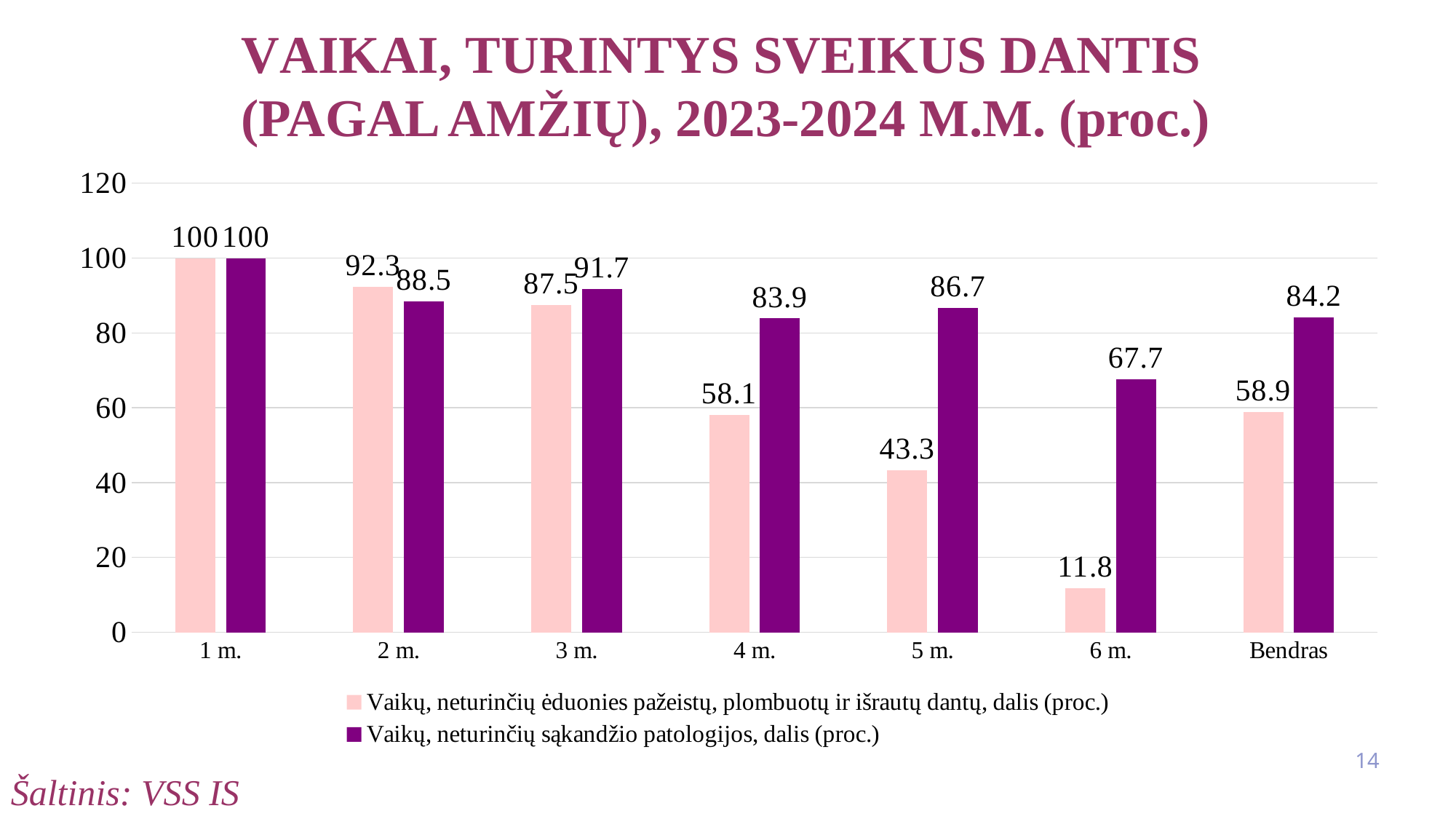
What is the value for Bendras in the series 'Vaikų, neturinčių ėduonies pažeistų, plombuotų ir išrautų dantų, dalis (proc.)'? 58.9 What is the value for 4 m. in the series 'Vaikų, neturinčių ėduonies pažeistų, plombuotų ir išrautų dantų, dalis (proc.)'? 58.1 What is the value for 5 m. in the series 'Vaikų, neturinčių sąkandžio patologijos, dalis (proc.)'? 86.7 Which category has the lowest value in the series 'Vaikų, neturinčių ėduonies pažeistų, plombuotų ir išrautų dantų, dalis (proc.)'? 6 m. How many categories are shown on the x axis? 7 What kind of chart is shown on the slide? bar chart Which category has the lowest value in the series 'Vaikų, neturinčių sąkandžio patologijos, dalis (proc.)'? 6 m. For 2 m., which series has the larger value: 'Vaikų, neturinčių ėduonies pažeistų, plombuotų ir išrautų dantų, dalis (proc.)' or 'Vaikų, neturinčių sąkandžio patologijos, dalis (proc.)'? Vaikų, neturinčių ėduonies pažeistų, plombuotų ir išrautų dantų, dalis (proc.) Does the series 'Vaikų, neturinčių ėduonies pažeistų, plombuotų ir išrautų dantų, dalis (proc.)' rise or fall from 1 m. to 6 m.? fall What is the difference between the two series' values for 6 m.? 55.9 How many series does the legend list? 2 Is the value for 5 m. in the series 'Vaikų, neturinčių ėduonies pažeistų, plombuotų ir išrautų dantų, dalis (proc.)' greater or less than 60? less